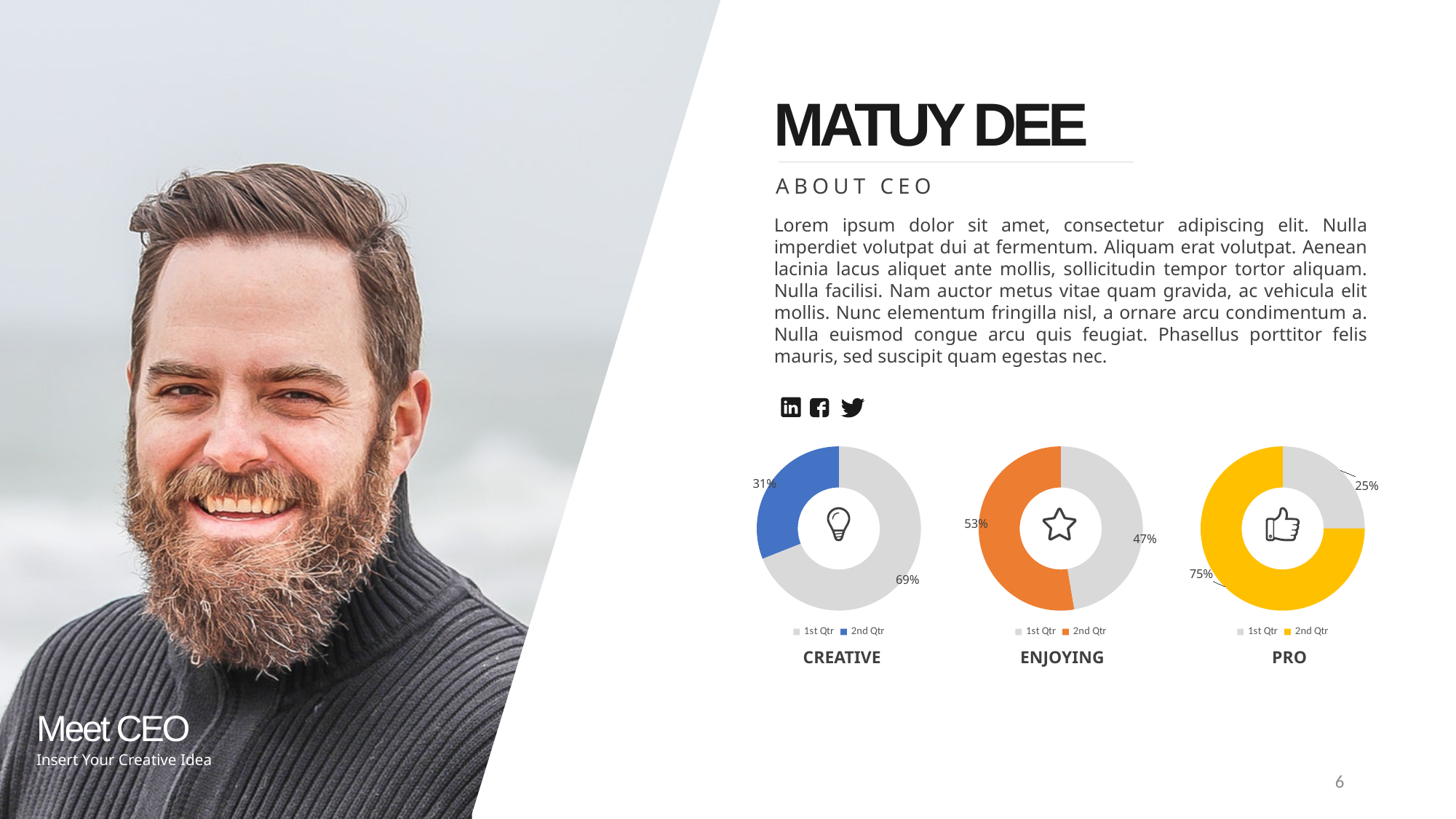
How many series does the legend of the ENJOYING chart list? 2 In the CREATIVE chart, what is the value for 2nd Qtr? 31% In the PRO chart, which quarter has the larger share? 2nd Qtr In the PRO chart, what is the value for 1st Qtr? 25% In the ENJOYING chart, is the value for 2nd Qtr larger or smaller than the value for 1st Qtr? larger In the ENJOYING chart, what is the value for 2nd Qtr? 53% In the PRO chart, what is the difference between the 2nd Qtr and 1st Qtr values? 50% In the CREATIVE chart, which quarter has the smaller share? 2nd Qtr What kind of chart is the PRO chart? Doughnut chart In the CREATIVE chart, what is the value for 1st Qtr? 69% In the CREATIVE chart, what is the difference between the 1st Qtr and 2nd Qtr values? 38% In the PRO chart, what is the value for 2nd Qtr? 75%